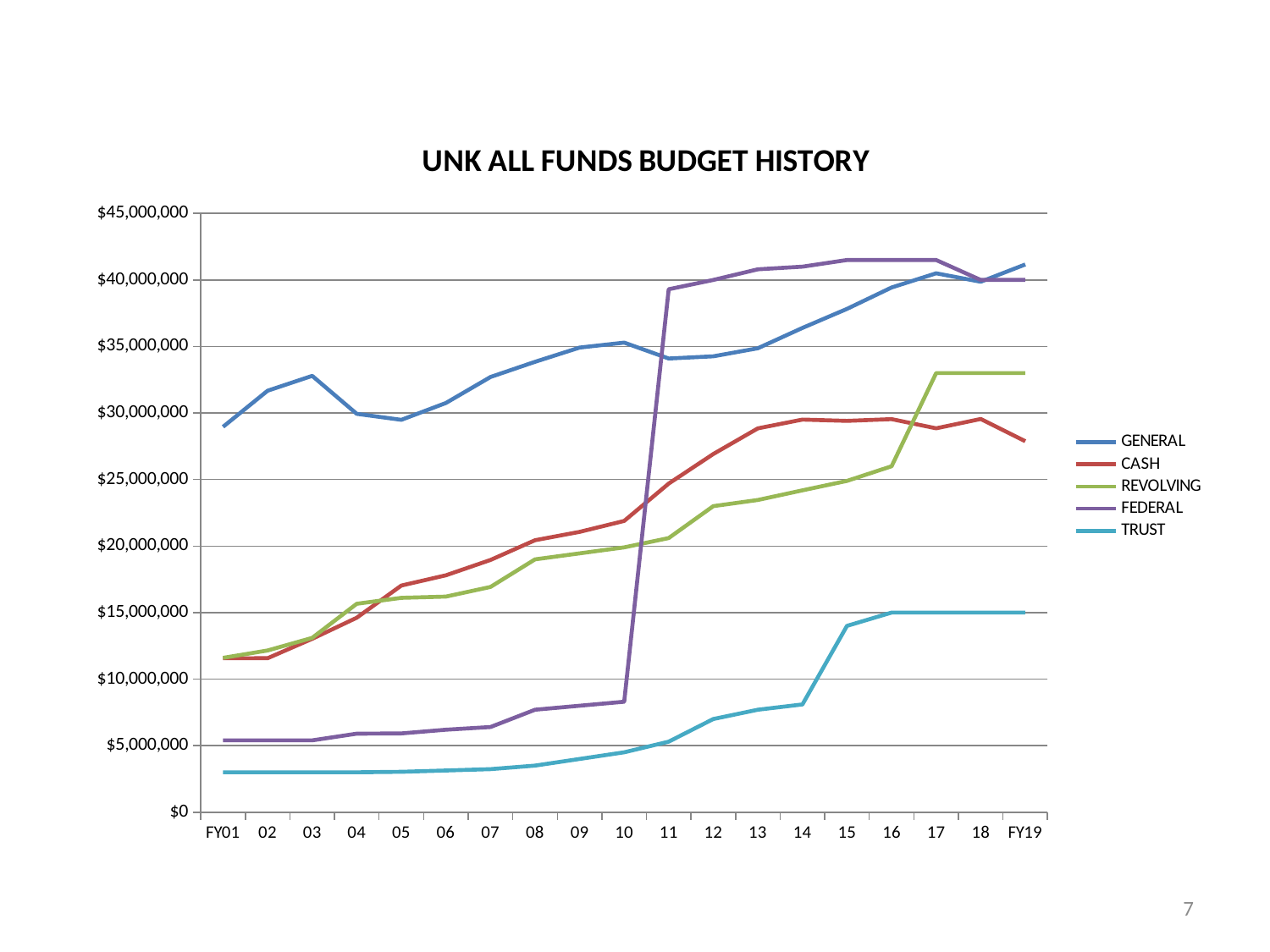
How many fiscal years are plotted along the x axis? 19 In FY11, which is larger, FEDERAL or GENERAL? FEDERAL What is the title of the chart? UNK ALL FUNDS BUDGET HISTORY Is the value for TRUST in FY01 greater or less than $5,000,000? less Is the value for GENERAL in FY01 greater or less than $30,000,000? less Which series has the highest value in FY15? FEDERAL How many series does the legend list? 5 What kind of chart is shown on the slide? Line chart Which series has the highest value in FY01? GENERAL Does the TRUST series generally rise or fall from FY01 to FY19? rise Which series has the lowest value in FY19? TRUST Is the value for FEDERAL in FY11 greater or less than $35,000,000? greater